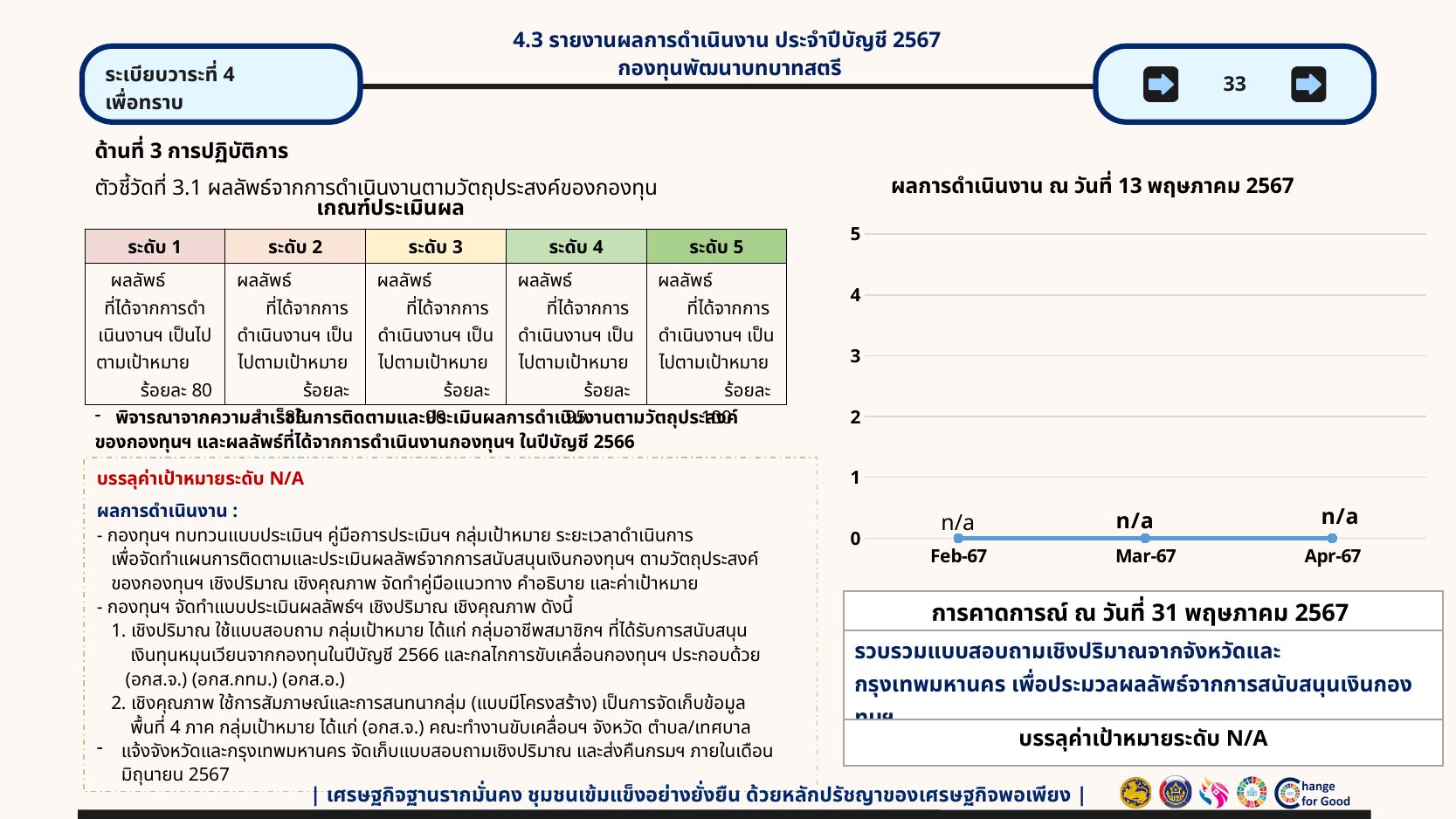
What is the data label shown for Apr-67 on the line chart? n/a Which category labels appear on the x-axis of the line chart? Feb-67, Mar-67, Apr-67 How many data points are plotted on the line chart? 3 What is the title of the line chart? ผลการดำเนินงาน ณ วันที่ 13 พฤษภาคม 2567 What is the data label shown for Mar-67 on the line chart? n/a What kind of chart is shown on the right side of the slide? line chart What is the highest value shown on the y-axis of the line chart? 5 Does the line on the chart rise, fall, or stay flat from Feb-67 to Apr-67? stay flat What is the data label shown for Feb-67 on the line chart? n/a